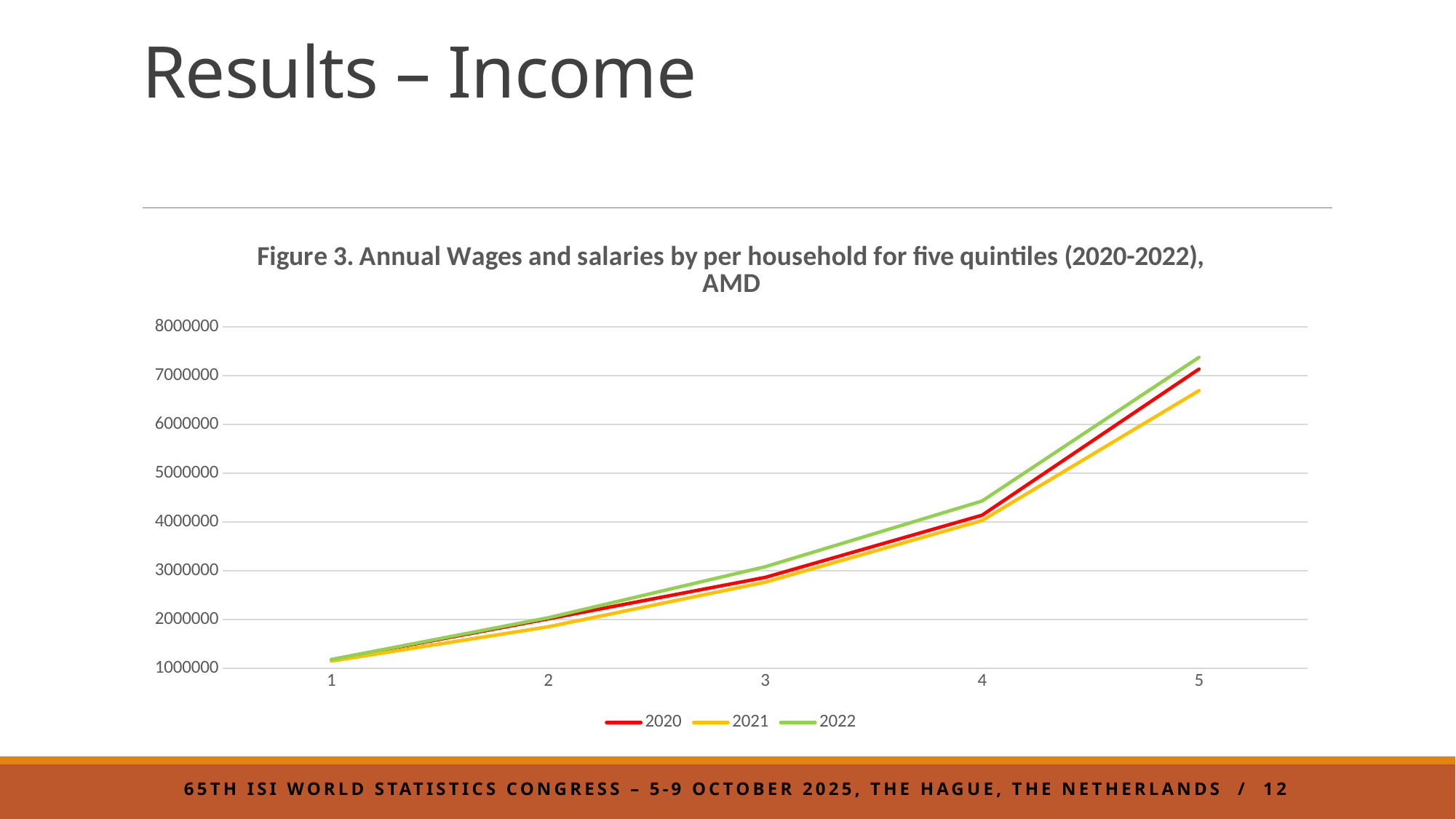
Which series has the highest value at quintile 5? 2022 Is the value for 2021 at quintile 5 greater or less than 7000000? less Is the value for 2022 at quintile 5 greater or less than 7000000? greater What kind of chart is shown on the slide? line chart Do the values for 2022 rise or fall from quintile 1 to quintile 5? rise For the 2020 series, which quintile has the highest value? 5 How many quintiles are plotted along the x axis? 5 Is the value for 2022 at quintile 4 greater or less than 4000000? greater How many series does the legend list? 3 What colour is the line for the 2021 series? yellow At quintile 4, which is larger: the value for 2022 or the value for 2021? 2022 Which series has the lowest value at quintile 5? 2021